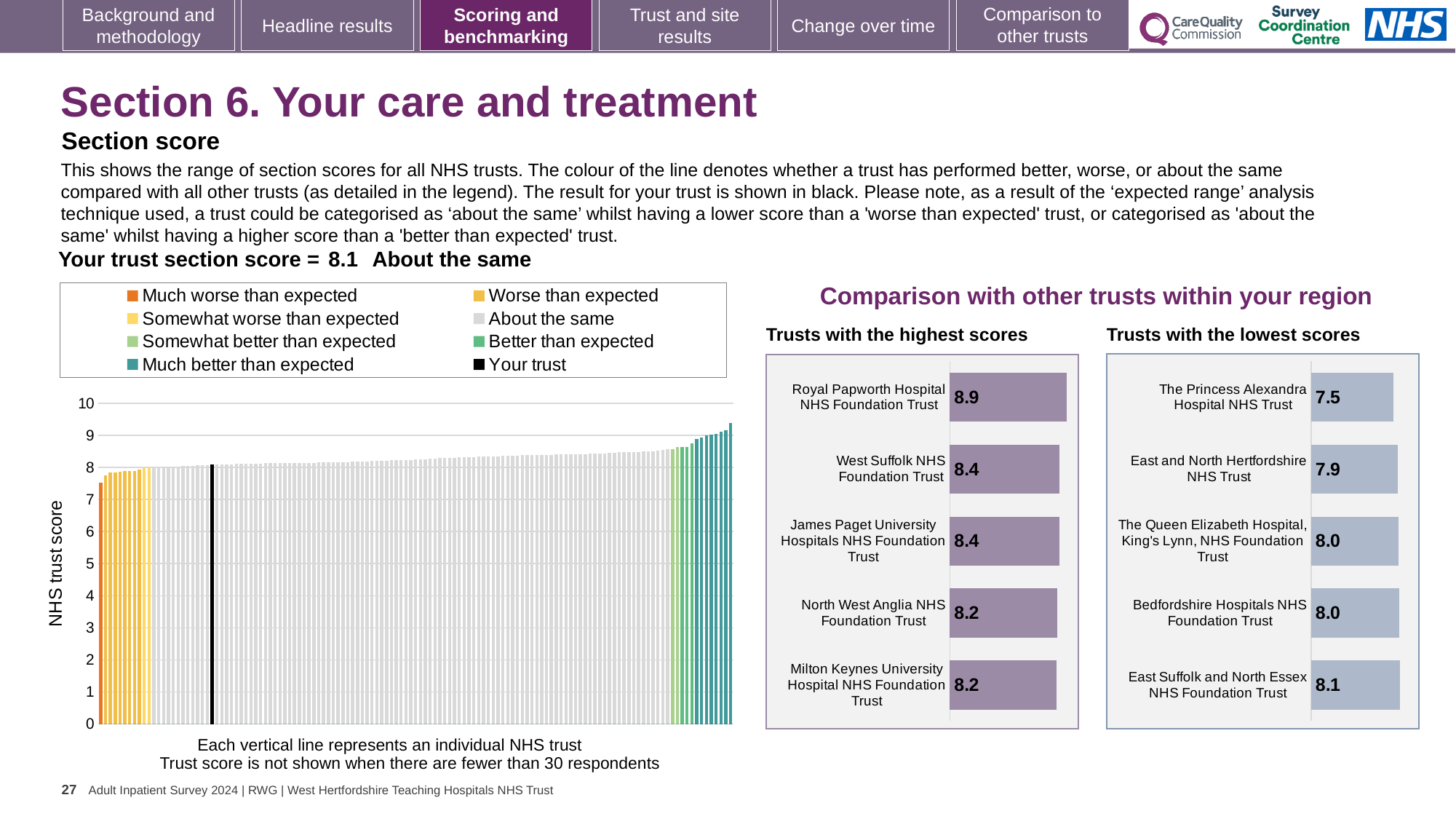
In the 'Trusts with the lowest scores' chart, what is the difference between the scores of East Suffolk and North Essex NHS Foundation Trust and The Princess Alexandra Hospital NHS Trust? 0.6 In the 'Trusts with the lowest scores' chart, what is the score for Bedfordshire Hospitals NHS Foundation Trust? 8.0 In the 'Trusts with the lowest scores' chart, which has the larger score: East and North Hertfordshire NHS Trust or The Princess Alexandra Hospital NHS Trust? East and North Hertfordshire NHS Trust How many entries does the legend of the NHS trust score chart on the left list? 8 In the 'Trusts with the highest scores' chart, which trust has the highest score? Royal Papworth Hospital NHS Foundation Trust In the NHS trust score chart on the left, what colour is used for 'Your trust' according to the legend? Black In the 'Trusts with the highest scores' chart, what is the difference between the scores of Royal Papworth Hospital NHS Foundation Trust and West Suffolk NHS Foundation Trust? 0.5 What kind of chart is the NHS trust score chart on the left of the slide? Bar chart How many trusts are shown in the 'Trusts with the highest scores' chart? 5 In the 'Trusts with the highest scores' chart, what is the score for Royal Papworth Hospital NHS Foundation Trust? 8.9 In the NHS trust score chart on the left, do the values rise or fall from left to right? Rise In the 'Trusts with the lowest scores' chart, which trust has the lowest score? The Princess Alexandra Hospital NHS Trust